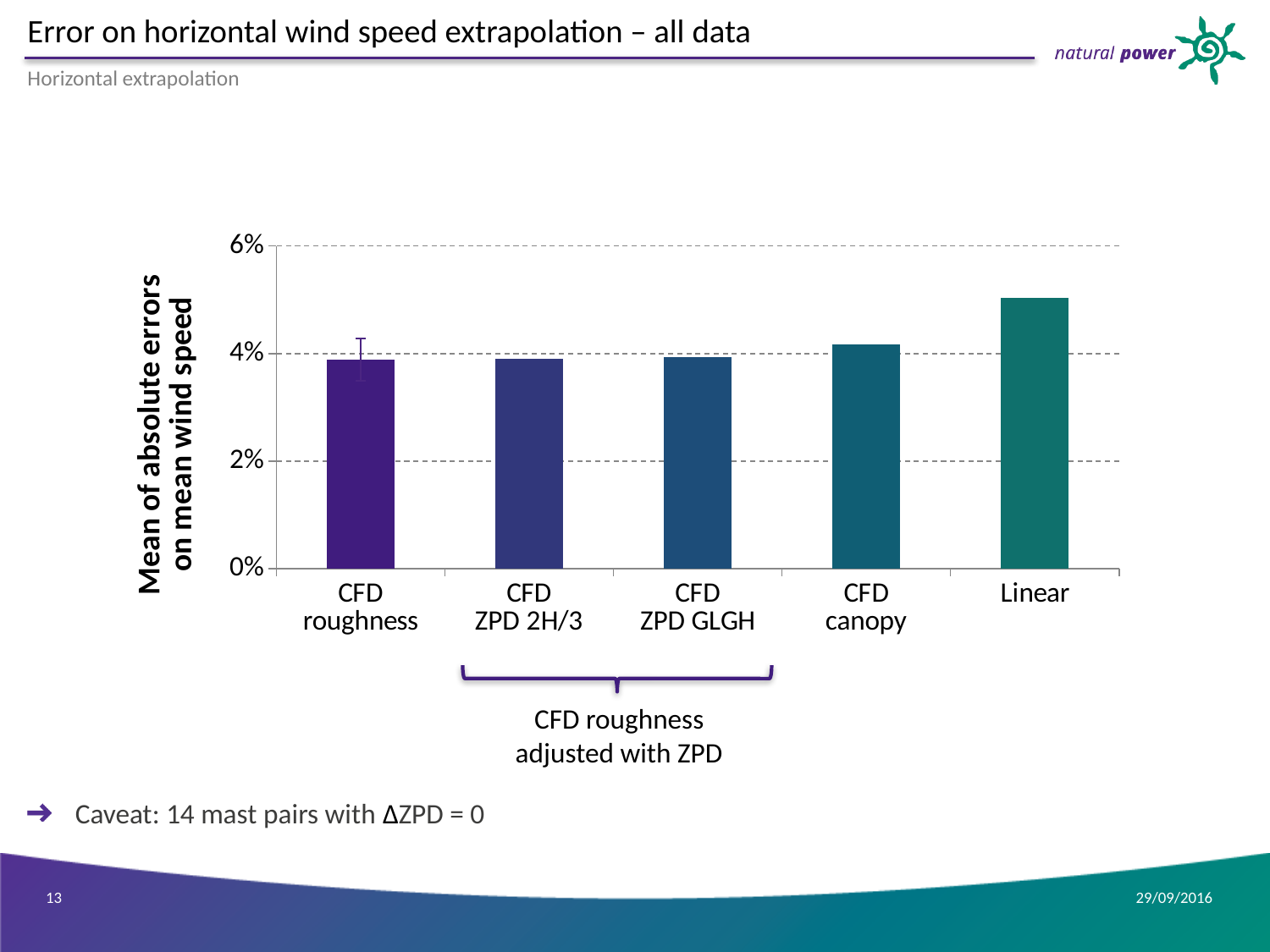
Is the value for Linear greater or less than 4%? greater What kind of chart is shown on the slide? bar chart Is the value for CFD ZPD GLGH greater or less than 2%? greater How many categories (bars) are plotted in the chart? 5 Is the value for Linear greater or less than 6%? less Which bar in the chart has an error bar drawn on it? CFD roughness Which category has the highest mean of absolute errors on mean wind speed? Linear Which is larger, the value for CFD canopy or the value for CFD ZPD 2H/3? CFD canopy What is the label of the vertical axis of the chart? Mean of absolute errors on mean wind speed Do the bar values generally rise or fall from left to right along the x axis? rise Which is larger, the value for Linear or the value for CFD canopy? Linear